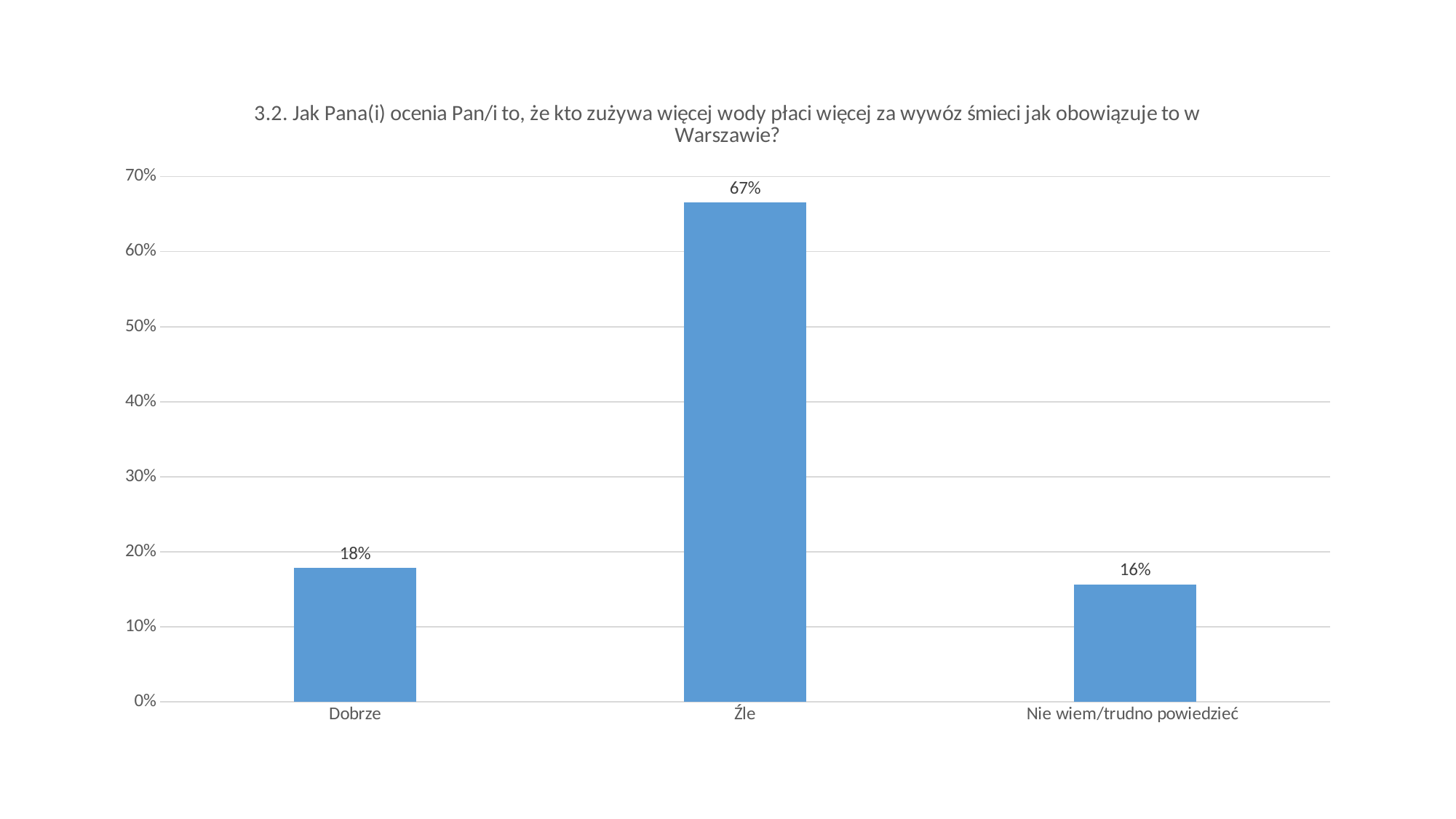
What kind of chart is shown on the slide? bar chart What is the value for Dobrze? 18% What is the difference between the values for Dobrze and Nie wiem/trudno powiedzieć? 2% How many categories are shown on the x axis? 3 Which category has the lowest value? Nie wiem/trudno powiedzieć What is the value for Źle? 67% Which category has the highest value? Źle Is the value for Źle greater or less than 60%? greater What is the highest value shown on the vertical axis? 70% What is the value for Nie wiem/trudno powiedzieć? 16% Which is larger, the value for Źle or the value for Dobrze? Źle What is the difference between the values for Źle and Dobrze? 49%